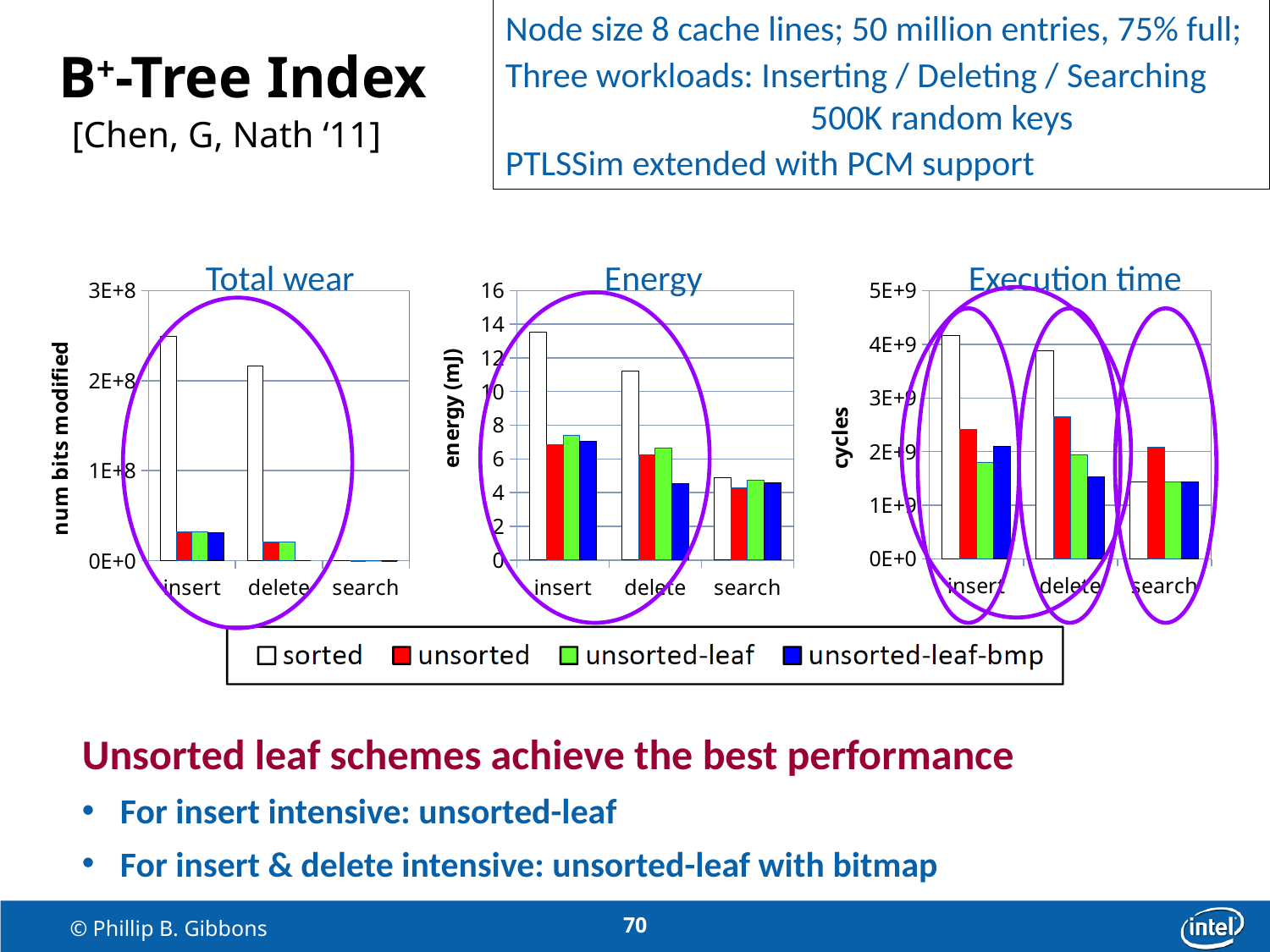
In the Total wear chart, which category has the highest bar? insert In the Energy chart, which is larger for the sorted series: insert or delete? insert What is the y-axis label of the Execution time chart? cycles In the Execution time chart, is the value for sorted under delete greater or less than 3E+9? greater How many workload categories are shown on the x axis of the Energy chart? 3 What kind of chart is the Total wear chart? bar chart How many series does the legend list for the charts? 4 In the Total wear chart, is the value for unsorted under insert greater or less than 1E+8? less In the Energy chart, is the value for sorted under insert greater or less than 12? greater In the Execution time chart, which series has the highest bar under insert? sorted In the Energy chart, does the sorted series rise or fall from insert to search? fall